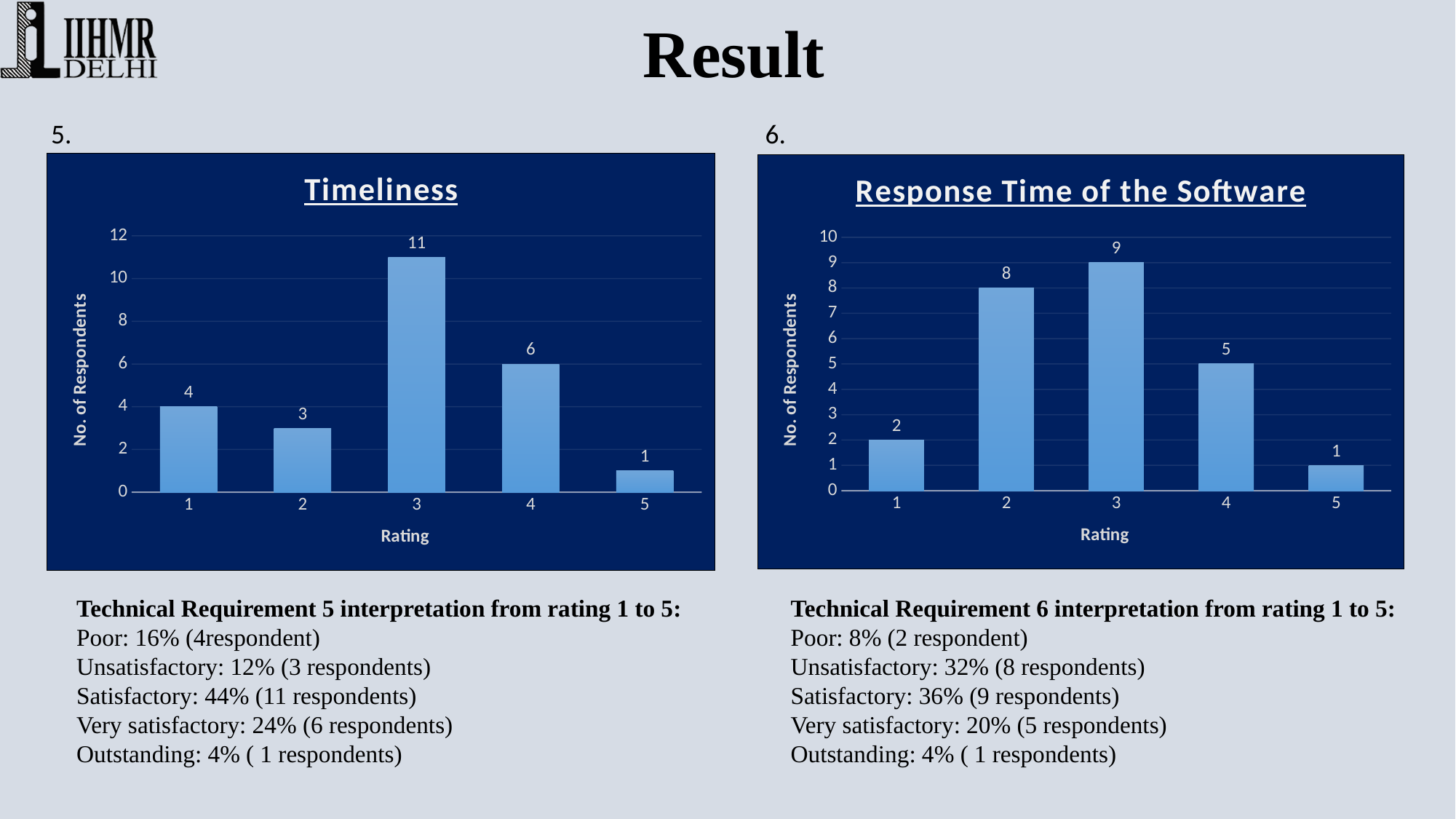
In the Response Time of the Software chart, how many respondents gave a rating of 2? 8 In the Response Time of the Software chart, which rating has the highest number of respondents? 3 In the Timeliness chart, how many rating categories are shown on the x axis? 5 In the Timeliness chart, what is the total number of respondents across all five ratings? 25 In the Timeliness chart, what is the difference between the number of respondents for rating 3 and rating 4? 5 In the Response Time of the Software chart, what is the difference between the number of respondents for rating 2 and rating 1? 6 What is the y-axis label of the Response Time of the Software chart? No. of Respondents In the Response Time of the Software chart, is the value for rating 4 greater or less than 4? greater In the Timeliness chart, which rating has the lowest number of respondents? 5 What type of chart is the Timeliness chart? bar chart In the Timeliness chart, how many respondents gave a rating of 3? 11 In the Response Time of the Software chart, which has more respondents, rating 1 or rating 4? rating 4